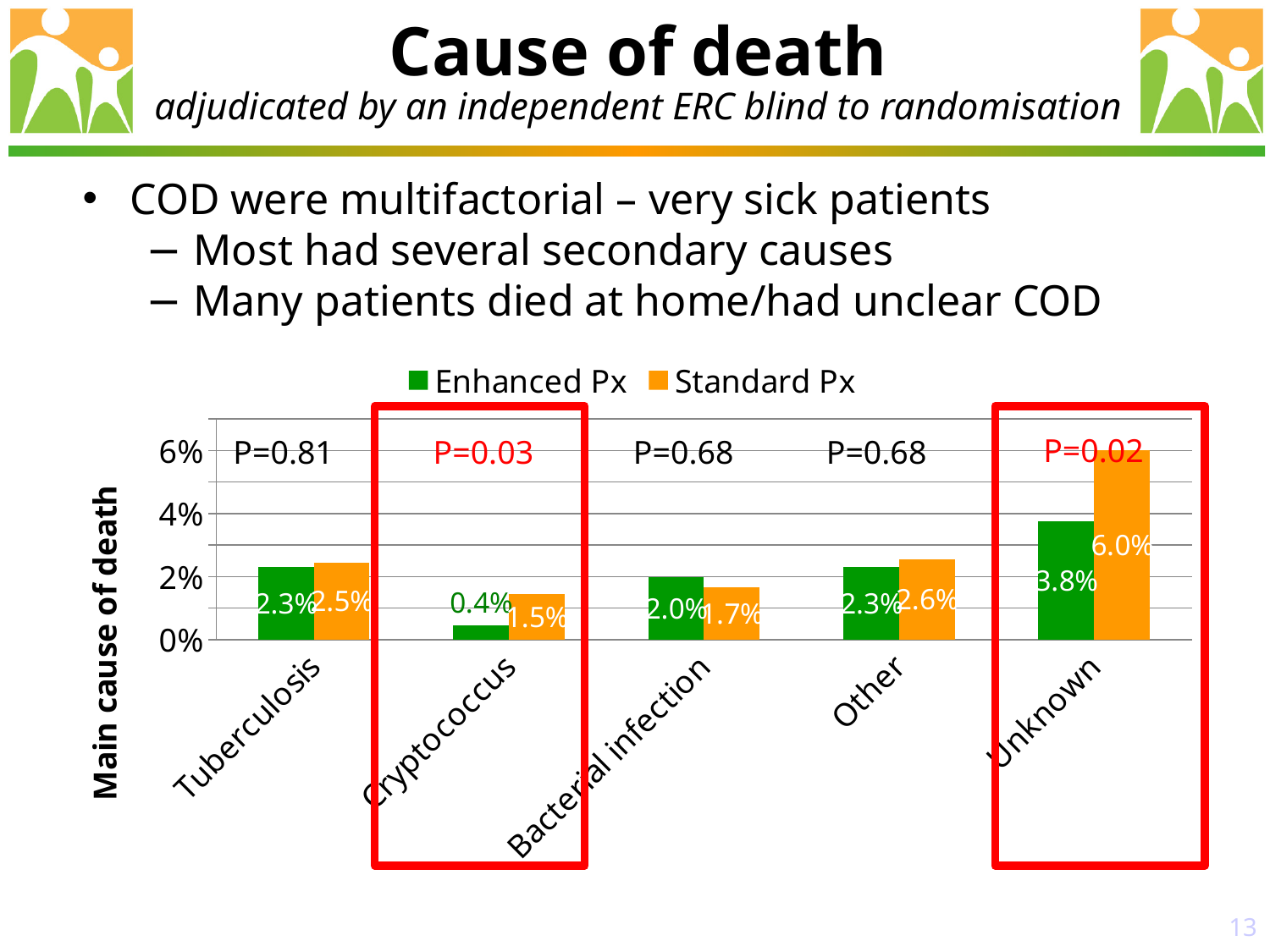
What is the value for Enhanced Px for Bacterial infection? 2.0% What is the value for Standard Px for Unknown? 6.0% What is the value for Standard Px for Cryptococcus? 1.5% Which category has the lowest Enhanced Px value? Cryptococcus For Bacterial infection, which is larger: Enhanced Px or Standard Px? Enhanced Px What is the value for Enhanced Px for Tuberculosis? 2.3% What P value is shown above the Cryptococcus bars? P=0.03 What kind of chart is shown? Bar chart How many series does the legend list? 2 Which category has the highest Standard Px value? Unknown What is the difference between the Standard Px and Enhanced Px values for Unknown? 2.2% How many categories are shown on the x axis? 5